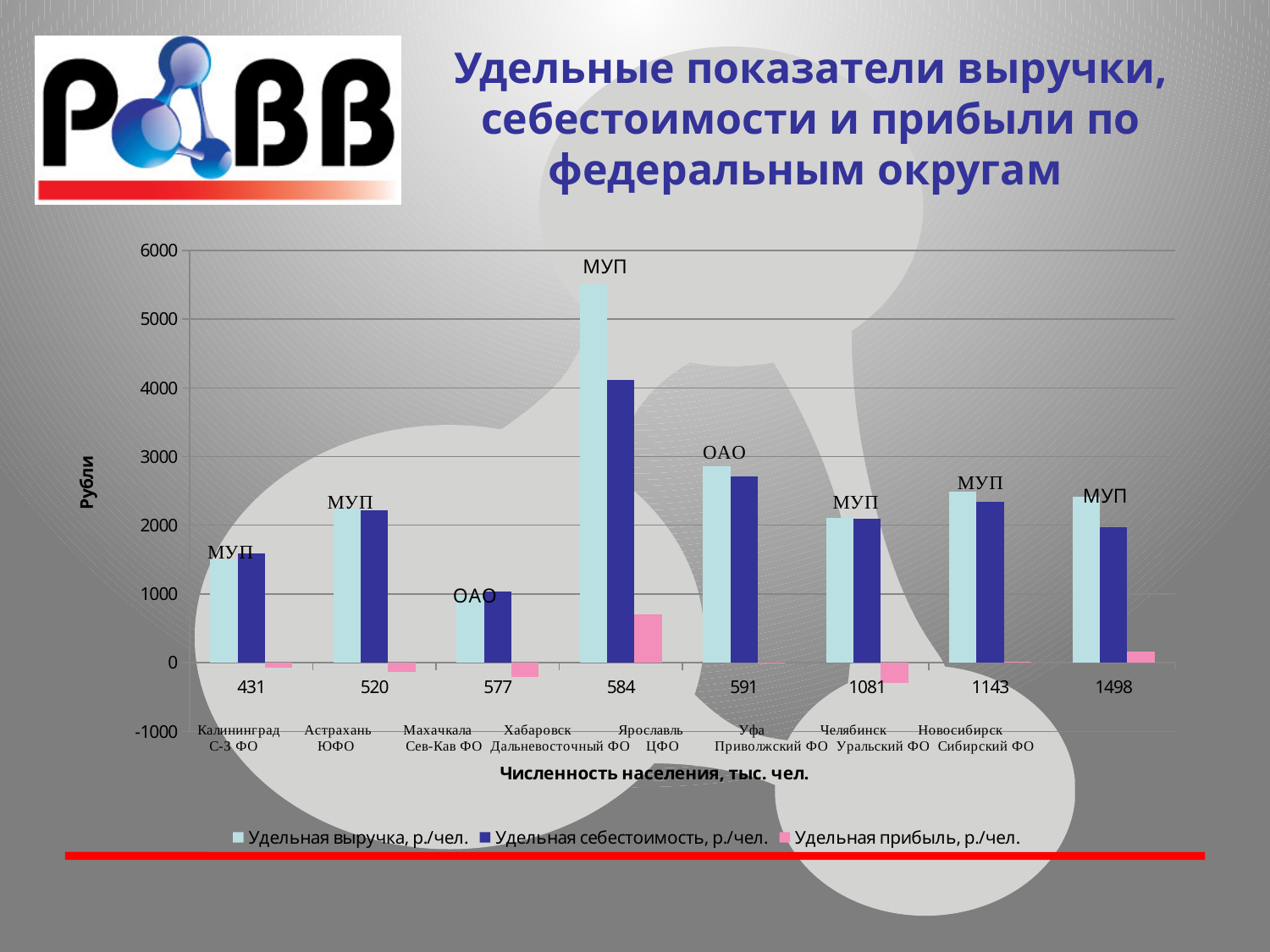
What is the label of the y axis? Рубли Which is larger, the Удельная себестоимость, р./чел. for category 431 or for category 520? 520 How many series does the legend list? 3 Which population category has the highest value for Удельная выручка, р./чел.? 584 Is the value of Удельная выручка, р./чел. for category 431 greater or less than 2000? less What kind of chart is shown on the slide? bar chart Is the value of Удельная выручка, р./чел. for category 584 greater or less than 5000? greater Which population category has the highest value for Удельная себестоимость, р./чел.? 584 How many population categories are shown on the x axis? 8 Which population category has the lowest value for Удельная выручка, р./чел.? 577 Which population category has the highest value for Удельная прибыль, р./чел.? 584 Is the value of Удельная прибыль, р./чел. for category 584 greater or less than 1000? less